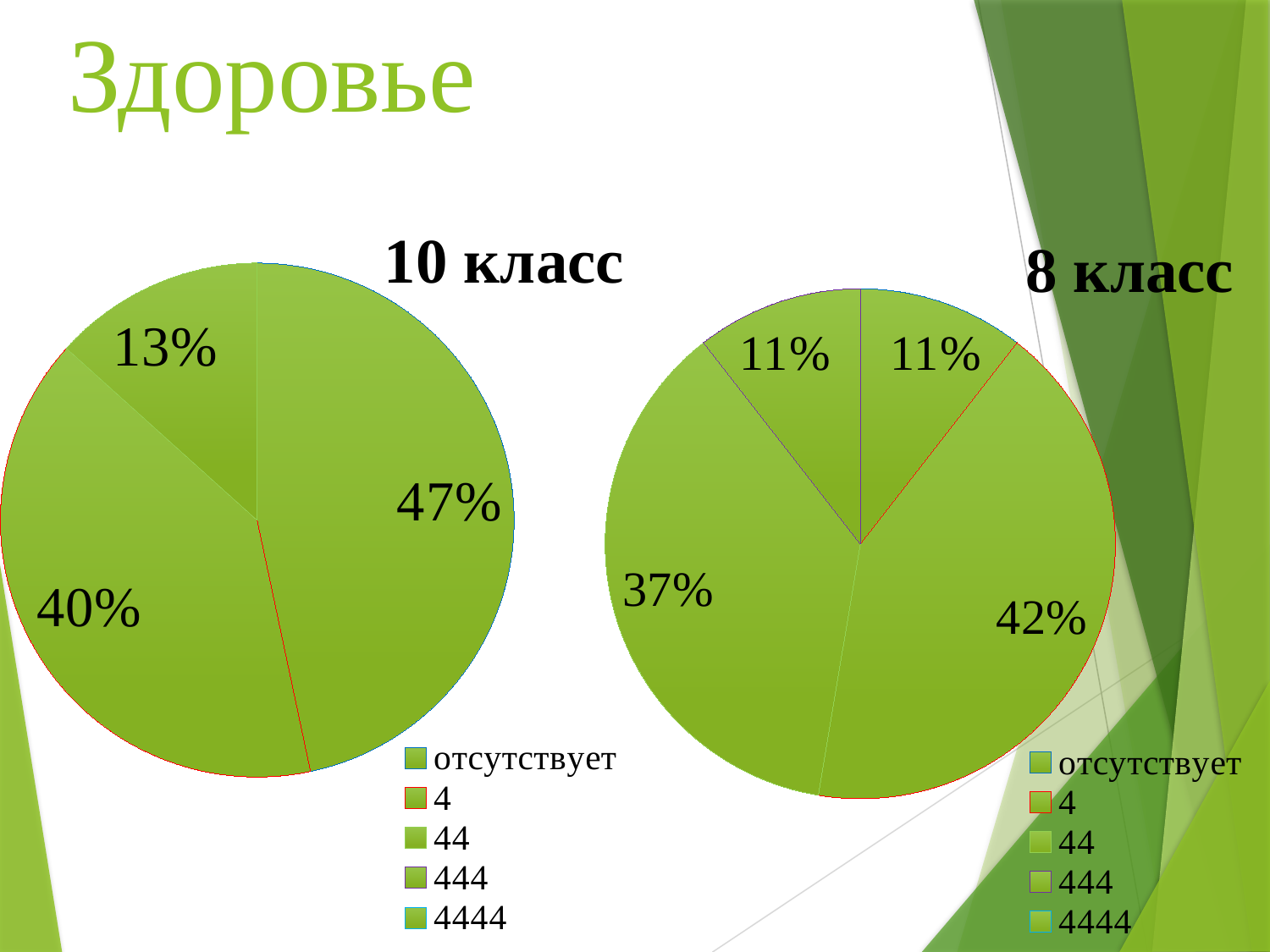
Which chart has the larger biggest slice, "10 класс" or "8 класс"? 10 класс In the "10 класс" pie chart, what is the percentage of the smallest slice? 13% How many slices are labelled in the "10 класс" pie chart? 3 In the "10 класс" pie chart, what is the percentage of the largest slice? 47% What kind of chart is the "10 класс" chart? pie chart In the "8 класс" pie chart, what is the percentage of the largest slice? 42% How many slices are labelled in the "8 класс" pie chart? 4 In the "10 класс" pie chart, what is the difference in percentage points between the largest slice (47%) and the smallest slice (13%)? 34 percentage points In the "8 класс" pie chart, what is the percentage of the smallest slices? 11% In the "8 класс" pie chart, what is the difference in percentage points between the 42% slice and the 37% slice? 5 percentage points How many entries does the legend of the "10 класс" chart list? 5 What is the first entry listed in the legend of the "8 класс" chart? отсутствует